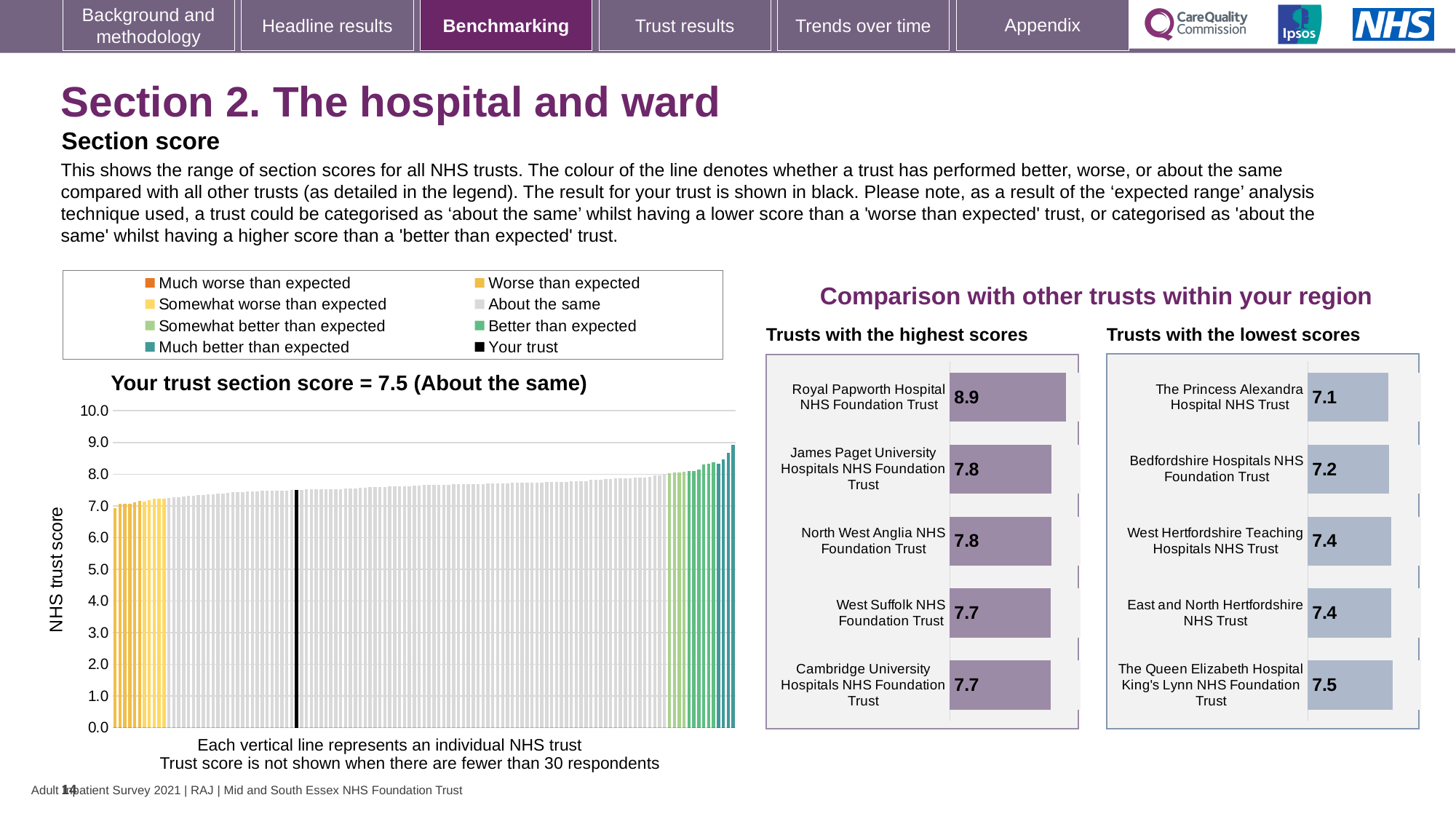
In the 'Your trust section score' chart, is the value of the tallest bar greater or less than 8.0? greater In the 'Trusts with the lowest scores' chart, which trust has the lowest score? The Princess Alexandra Hospital NHS Trust How many entries does the legend above the 'Your trust section score' chart list? 8 In the 'Trusts with the lowest scores' chart, which has the larger score: Bedfordshire Hospitals NHS Foundation Trust or The Queen Elizabeth Hospital King's Lynn NHS Foundation Trust? The Queen Elizabeth Hospital King's Lynn NHS Foundation Trust In the 'Your trust section score' chart, what category is your trust placed in? About the same In the 'Trusts with the highest scores' chart, what is the score for Royal Papworth Hospital NHS Foundation Trust? 8.9 What kind of chart is the 'Your trust section score' chart? bar chart In the 'Your trust section score' chart, do the trust scores rise or fall from left to right along the x axis? rise In the 'Trusts with the highest scores' chart, which trust has the highest score? Royal Papworth Hospital NHS Foundation Trust In the 'Your trust section score' chart, what is the section score for your trust? 7.5 In the 'Trusts with the highest scores' chart, what is the difference between the scores of Royal Papworth Hospital NHS Foundation Trust and West Suffolk NHS Foundation Trust? 1.2 How many trusts are shown in the 'Trusts with the lowest scores' chart? 5